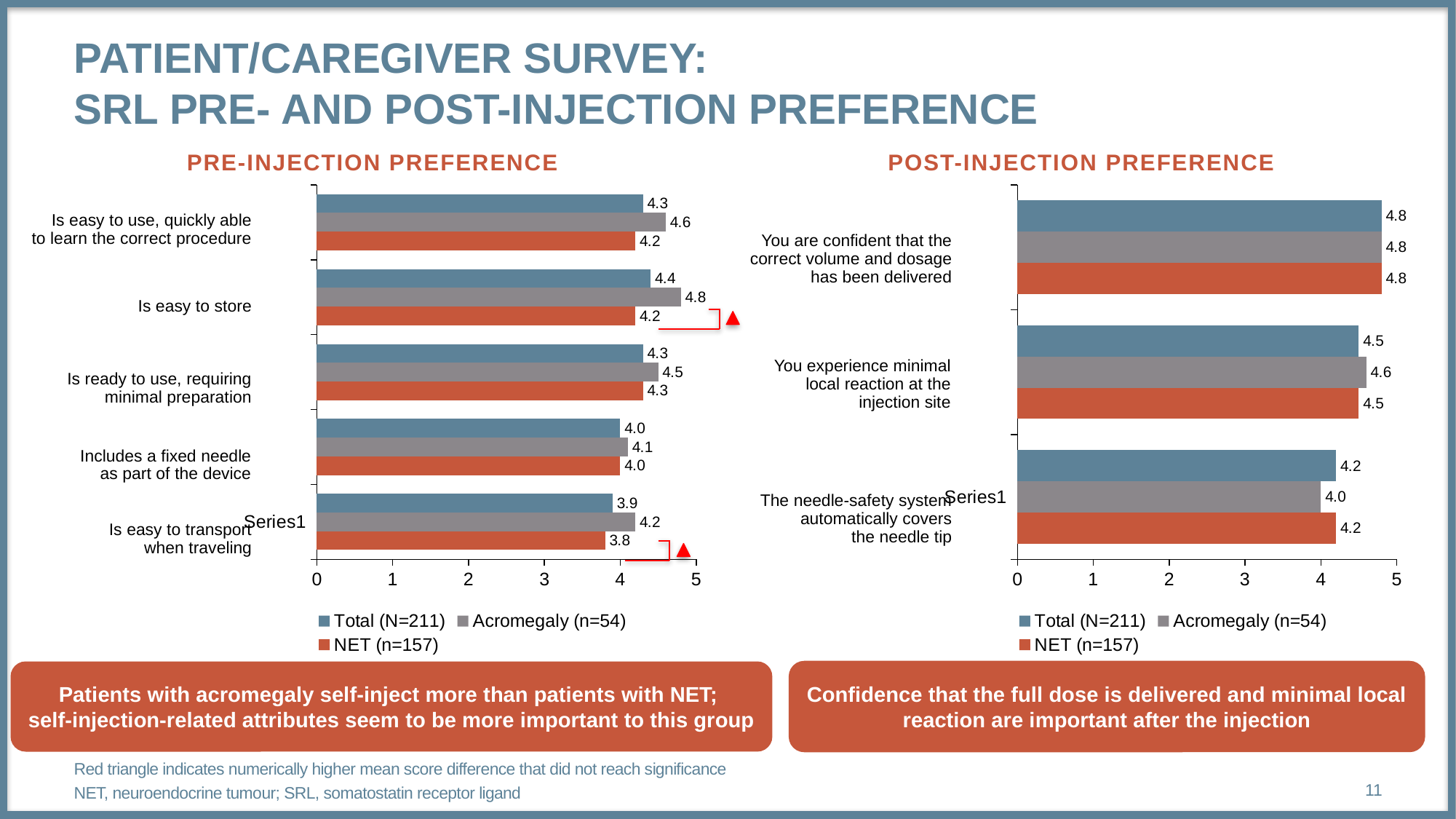
In the Post-Injection Preference chart, which category has the highest NET (n=157) value? You are confident that the correct volume and dosage has been delivered How many series does the legend of the Post-Injection Preference chart list? 3 In the Pre-Injection Preference chart, what is the Acromegaly (n=54) value for 'Is easy to store'? 4.8 In the Post-Injection Preference chart, what is the Total (N=211) value for 'You experience minimal local reaction at the injection site'? 4.5 In the Pre-Injection Preference chart, what is the difference between the Acromegaly (n=54) and NET (n=157) values for 'Is easy to store'? 0.6 In the Post-Injection Preference chart, what is the Acromegaly (n=54) value for 'The needle-safety system automatically covers the needle tip'? 4.0 How many categories are shown in the Pre-Injection Preference chart? 5 In the Pre-Injection Preference chart, which is larger for 'Is easy to use, quickly able to learn the correct procedure': the Acromegaly (n=54) value or the NET (n=157) value? Acromegaly (n=54) In the Pre-Injection Preference chart, what is the NET (n=157) value for 'Is easy to transport when traveling'? 3.8 In the Post-Injection Preference chart, what is the difference between the Total (N=211) values for 'You are confident that the correct volume and dosage has been delivered' and 'The needle-safety system automatically covers the needle tip'? 0.6 What type of chart is the Post-Injection Preference chart? Bar chart In the Pre-Injection Preference chart, which category has the lowest Total (N=211) value? Is easy to transport when traveling